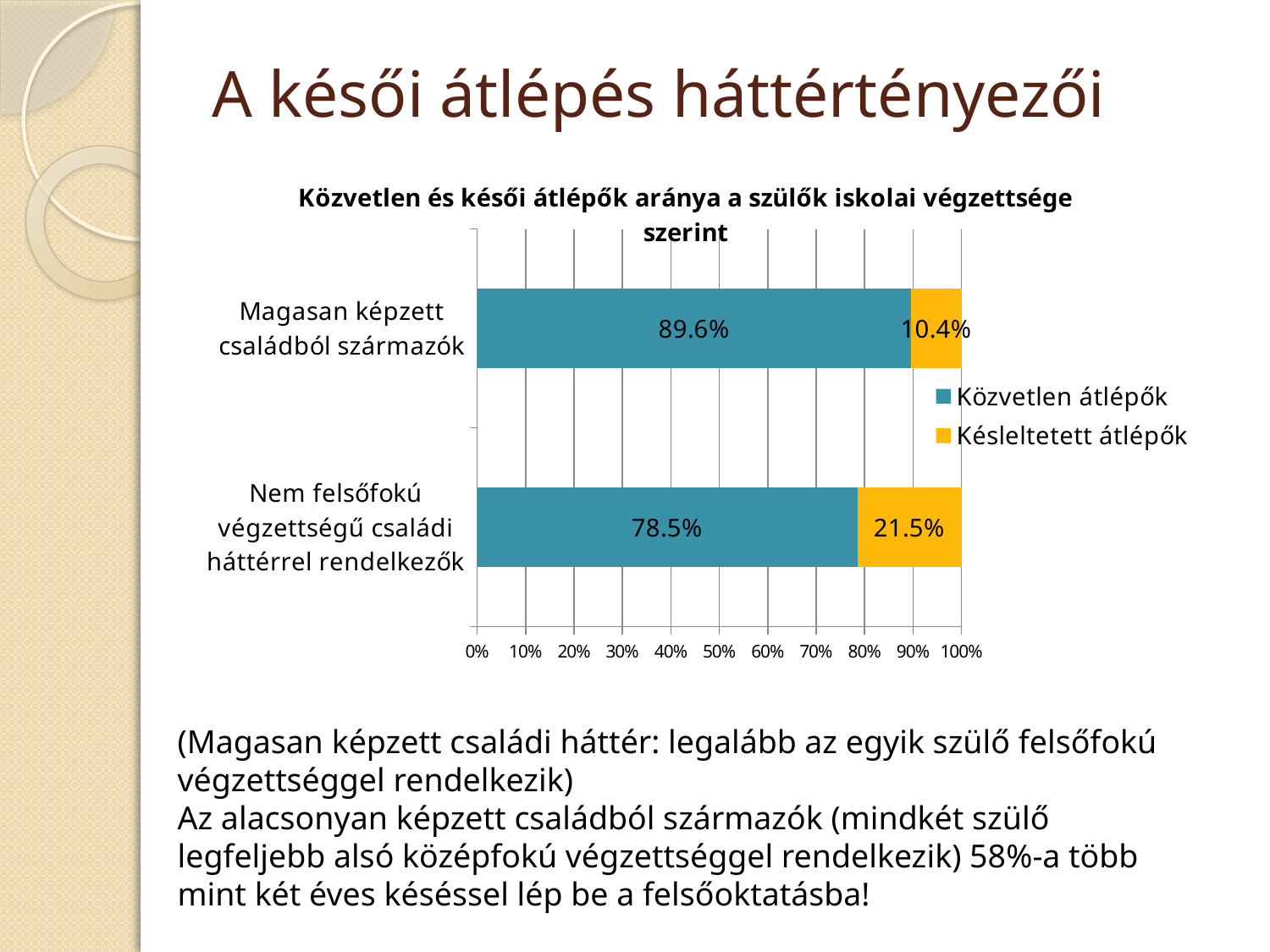
What is the value of Késleltetett átlépők for Magasan képzett családból származók? 10.4% Which category has the lower share of Közvetlen átlépők? Nem felsőfokú végzettségű családi háttérrel rendelkezők Which category has the higher share of Késleltetett átlépők? Nem felsőfokú végzettségű családi háttérrel rendelkezők How many series does the legend list? 2 Is the Közvetlen átlépők value for Nem felsőfokú végzettségű családi háttérrel rendelkezők greater or less than 80%? less What is the value of Közvetlen átlépők for Nem felsőfokú végzettségű családi háttérrel rendelkezők? 78.5% What type of chart is shown on the slide? Stacked bar chart What is the value of Késleltetett átlépők for Nem felsőfokú végzettségű családi háttérrel rendelkezők? 21.5% What is the difference in Közvetlen átlépők between Magasan képzett családból származók and Nem felsőfokú végzettségű családi háttérrel rendelkezők? 11.1% How many categories are shown on the chart? 2 What is the value of Közvetlen átlépők for Magasan képzett családból származók? 89.6% Which colour represents Késleltetett átlépők in the chart? Yellow/orange